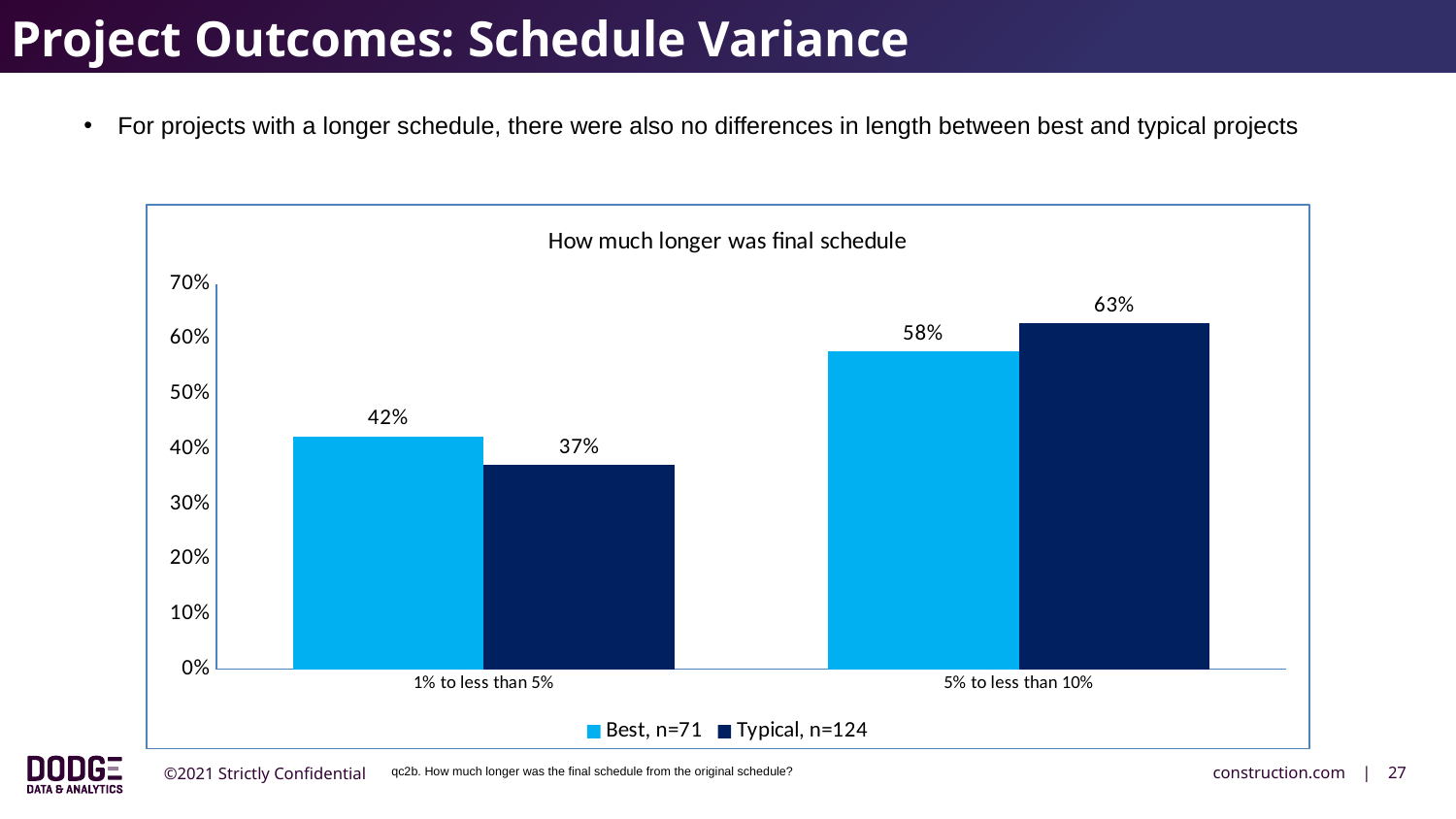
What is the value for Typical, n=124 in the '1% to less than 5%' category? 37% Which series has the lowest value in the '1% to less than 5%' category? Typical, n=124 What is the value for Best, n=71 in the '5% to less than 10%' category? 58% Which series has the highest value in the '5% to less than 10%' category? Typical, n=124 Is the Best, n=71 value larger in '1% to less than 5%' or in '5% to less than 10%'? 5% to less than 10% What is the difference between the Best and Typical values in the '1% to less than 5%' category? 5% How many series does the legend list? 2 What is the difference between the Typical and Best values in the '5% to less than 10%' category? 5% How many categories are shown on the x axis? 2 What is the value for Typical, n=124 in the '5% to less than 10%' category? 63% What type of chart is shown on the slide? Bar chart What is the value for Best, n=71 in the '1% to less than 5%' category? 42%